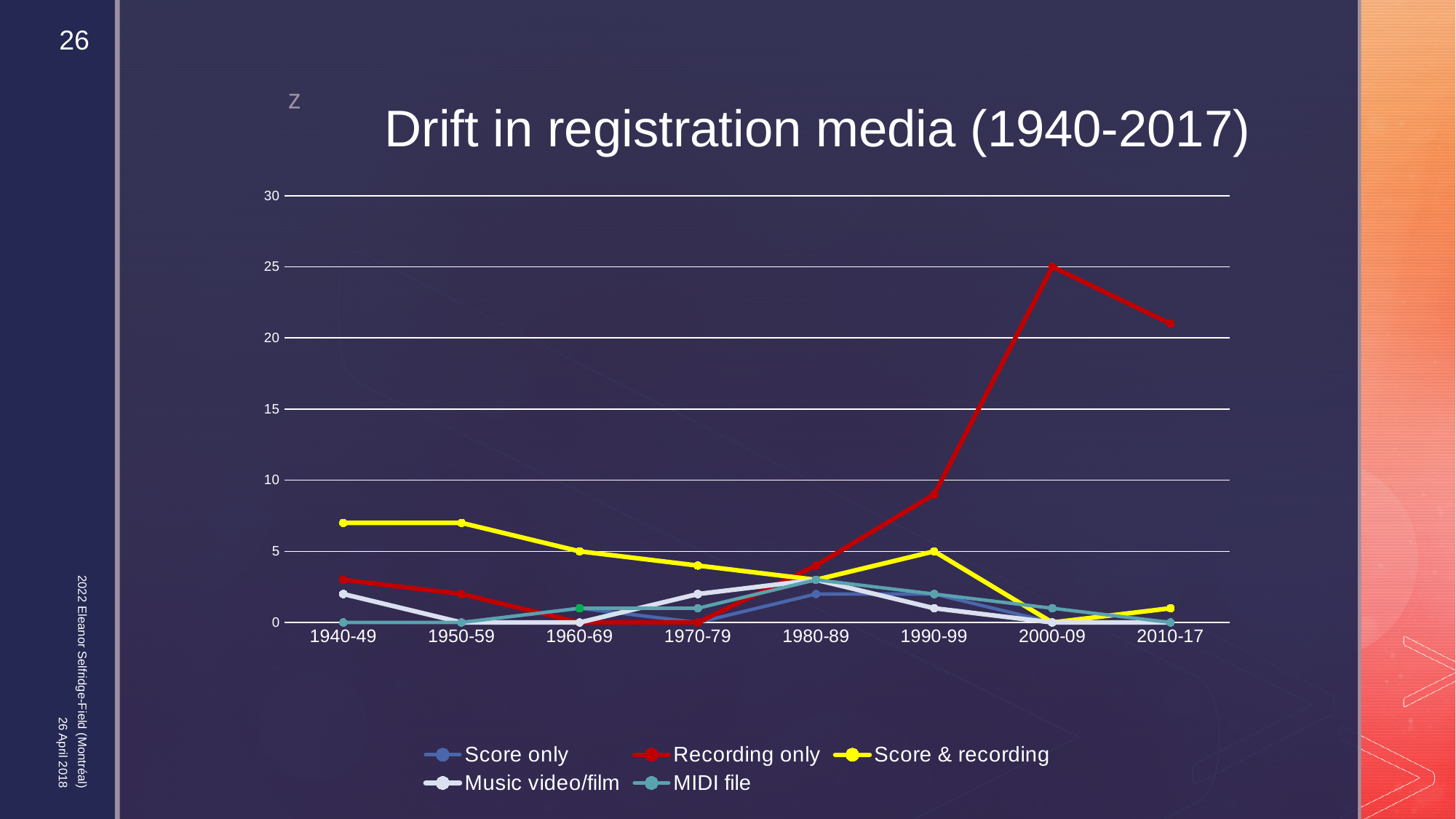
Does the Recording only series rise or fall from 1980-89 to 2000-09? rise Is the value for Recording only in 1990-99 greater or less than 10? less How many time periods are shown on the x axis? 8 What is the value for Score & recording in 1960-69? 5 How many series does the legend list? 5 Which series reaches the highest value on the chart? Recording only What type of chart is shown on the slide? line chart What is the value for Recording only in 2000-09? 25 Is the value for Recording only in 2010-17 greater or less than 20? greater What is the value for MIDI file in 1940-49? 0 Is the value for Score & recording in 1940-49 greater or less than 5? greater In 1940-49, which is larger: Score & recording or Recording only? Score & recording